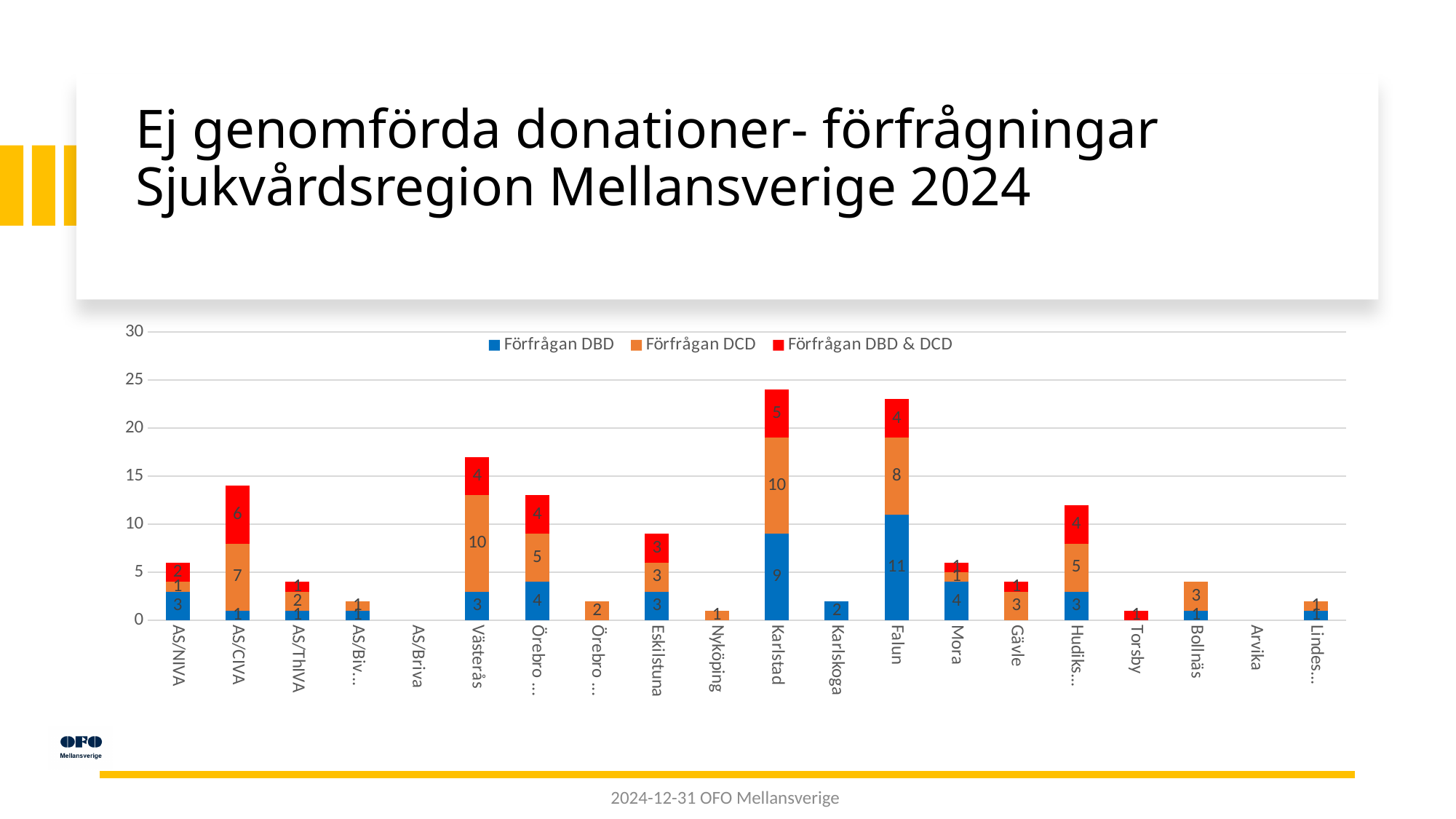
What is the Förfrågan DBD value for Karlstad? 9 What is the Förfrågan DBD & DCD value for AS/CIVA? 6 Which colour represents Förfrågan DBD & DCD in the legend? Red Which category has the highest total stacked bar? Karlstad Which is larger, the Förfrågan DBD value for Falun or for Karlstad? Falun How many series does the legend list? 3 What is the Förfrågan DBD value for Falun? 11 What is the total of the stacked bar for Falun? 23 What kind of chart is shown on the slide? Stacked bar chart What is the difference between the Förfrågan DCD values for Karlstad and Falun? 2 What is the Förfrågan DCD value for Västerås? 10 What is the total of the stacked bar for Karlstad? 24